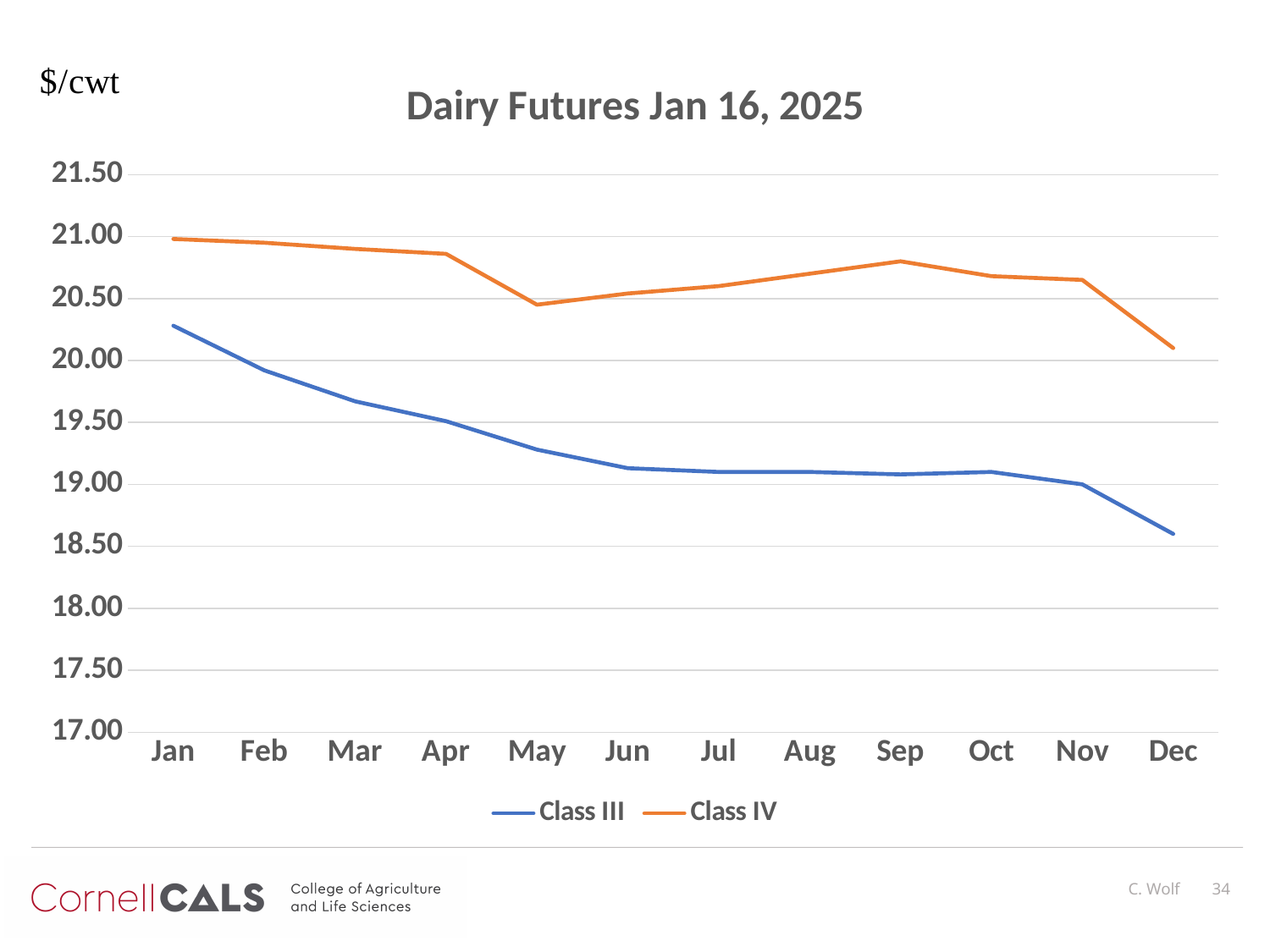
Is the Class III value for Dec greater or less than 19.00? less Does the Class III line generally rise or fall from Jan to Dec? fall How many months are plotted along the x axis? 12 In which month is the Class III value lowest? Dec How many series does the legend list? 2 Is the Class IV value for Sep greater or less than 20.50? greater Is the Class III value for Jan greater or less than 20.00? greater In which month is the Class III value highest? Jan Which series has the higher value in Jan, Class III or Class IV? Class IV In which month is the Class IV value lowest? Dec What kind of chart is shown on the slide? line chart